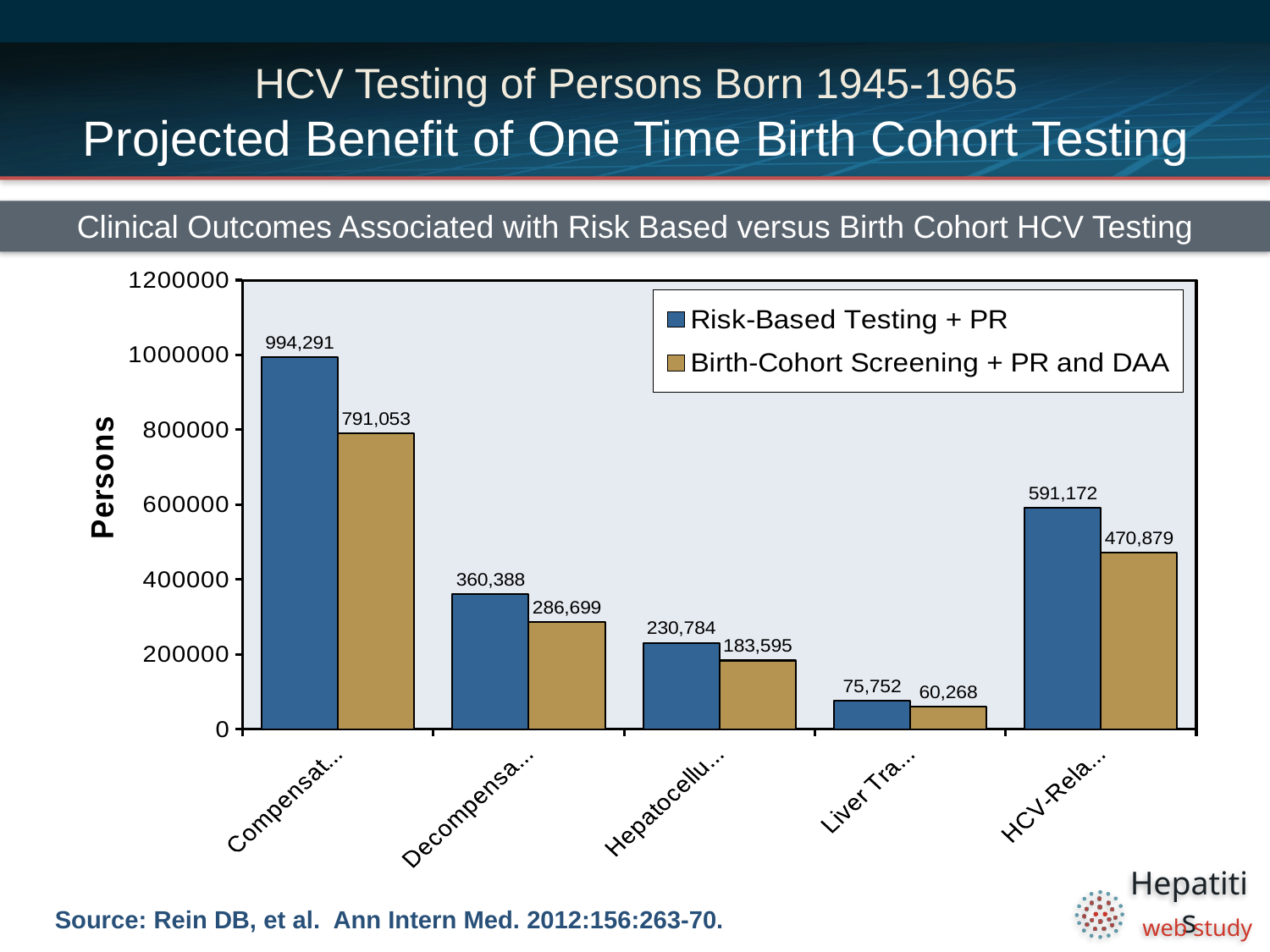
What is the Birth-Cohort Screening + PR and DAA value for the category labelled Liver Tra...? 60,268 What is the difference between the Risk-Based Testing + PR and Birth-Cohort Screening + PR and DAA values for the first category (Compensat...)? 203,238 How many categories are shown on the x axis? 5 Which category has the lowest Birth-Cohort Screening + PR and DAA value? Liver Tra... What is the difference between the Risk-Based Testing + PR and Birth-Cohort Screening + PR and DAA values for the category labelled HCV-Rela...? 120,293 What type of chart is shown on the slide? Bar chart For the category labelled Decompensa..., which series has the larger value: Risk-Based Testing + PR or Birth-Cohort Screening + PR and DAA? Risk-Based Testing + PR How many series does the legend list? 2 Which category has the highest Risk-Based Testing + PR value? Compensat... What is the Risk-Based Testing + PR value for the category labelled Hepatocellu...? 230,784 What is the Birth-Cohort Screening + PR and DAA value for the category labelled HCV-Rela...? 470,879 What is the Risk-Based Testing + PR value for the first category (Compensat...)? 994,291